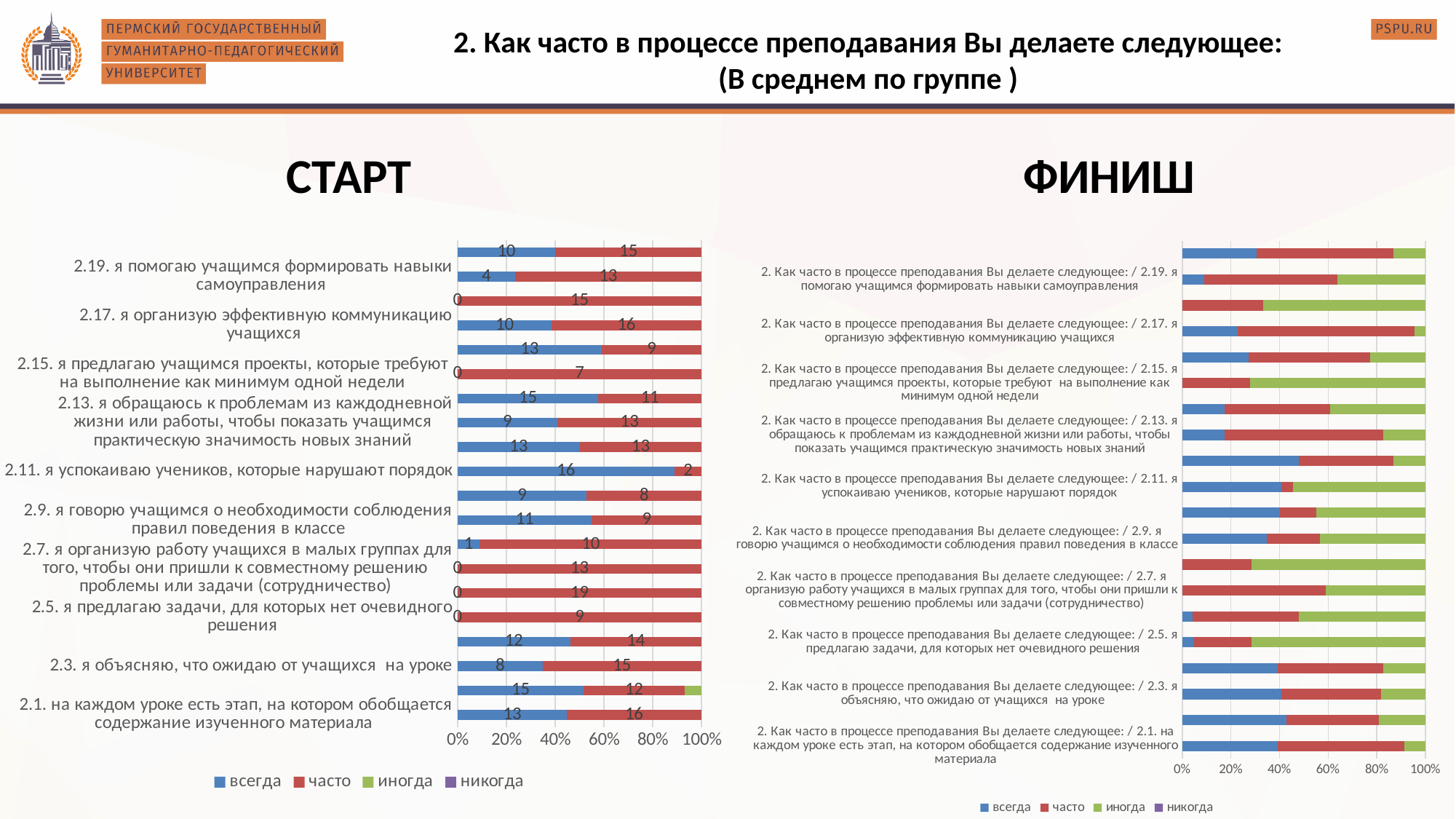
What kind of chart is the СТАРТ chart? bar chart In the СТАРТ chart, what is the часто value labelled on the bottom bar? 16 How many series does the legend of the ФИНИШ chart list? 4 In the СТАРТ chart, what is the difference between the часто and всегда values on the bottom bar? 3 In the СТАРТ chart, what is the всегда value labelled on the bottom bar? 13 In the СТАРТ chart, what is the часто value labelled on the top bar? 15 What is the maximum value shown on the x axis of the ФИНИШ chart? 100% In the СТАРТ chart, on the bottom bar, which is larger: the всегда value or the часто value? часто How many bars does the ФИНИШ chart contain? 20 In the ФИНИШ chart, is the всегда share of the bottom bar greater or less than 20%? greater What are the legend entries of the СТАРТ chart? всегда, часто, иногда, никогда In the СТАРТ chart, what is the largest часто value labelled on any bar? 19